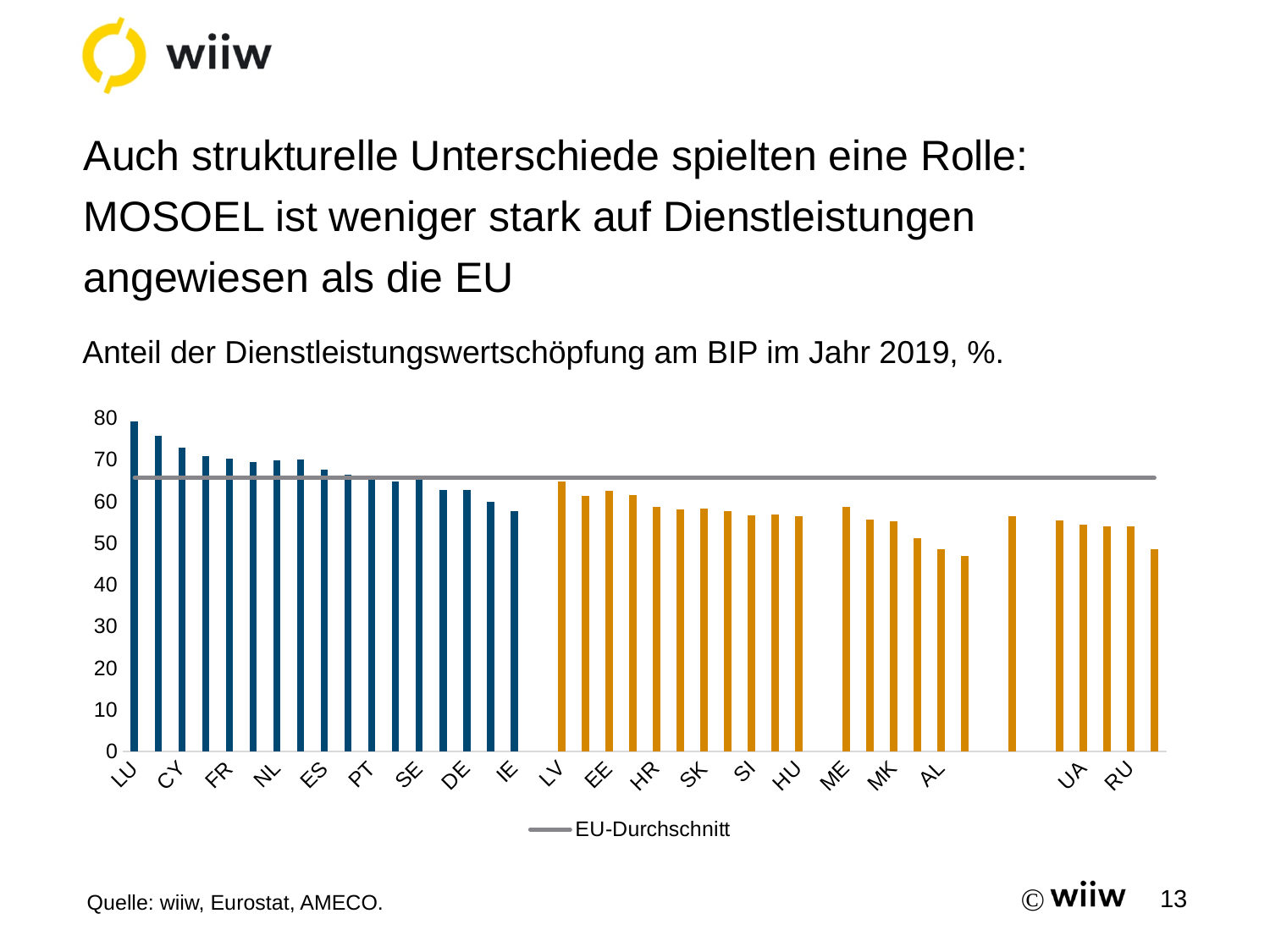
Which labelled country has the highest share of services value added in GDP? LU Is the value for MK greater or less than 60? less Is the value for LU greater or less than 70? greater Is the value for HU greater or less than 60? less What kind of chart is shown on the slide? bar chart Which has the larger value, LU or RU? LU What is the name of the horizontal line shown in the legend? EU-Durchschnitt Which has the larger value, CY or UA? CY How many entries does the legend list? 1